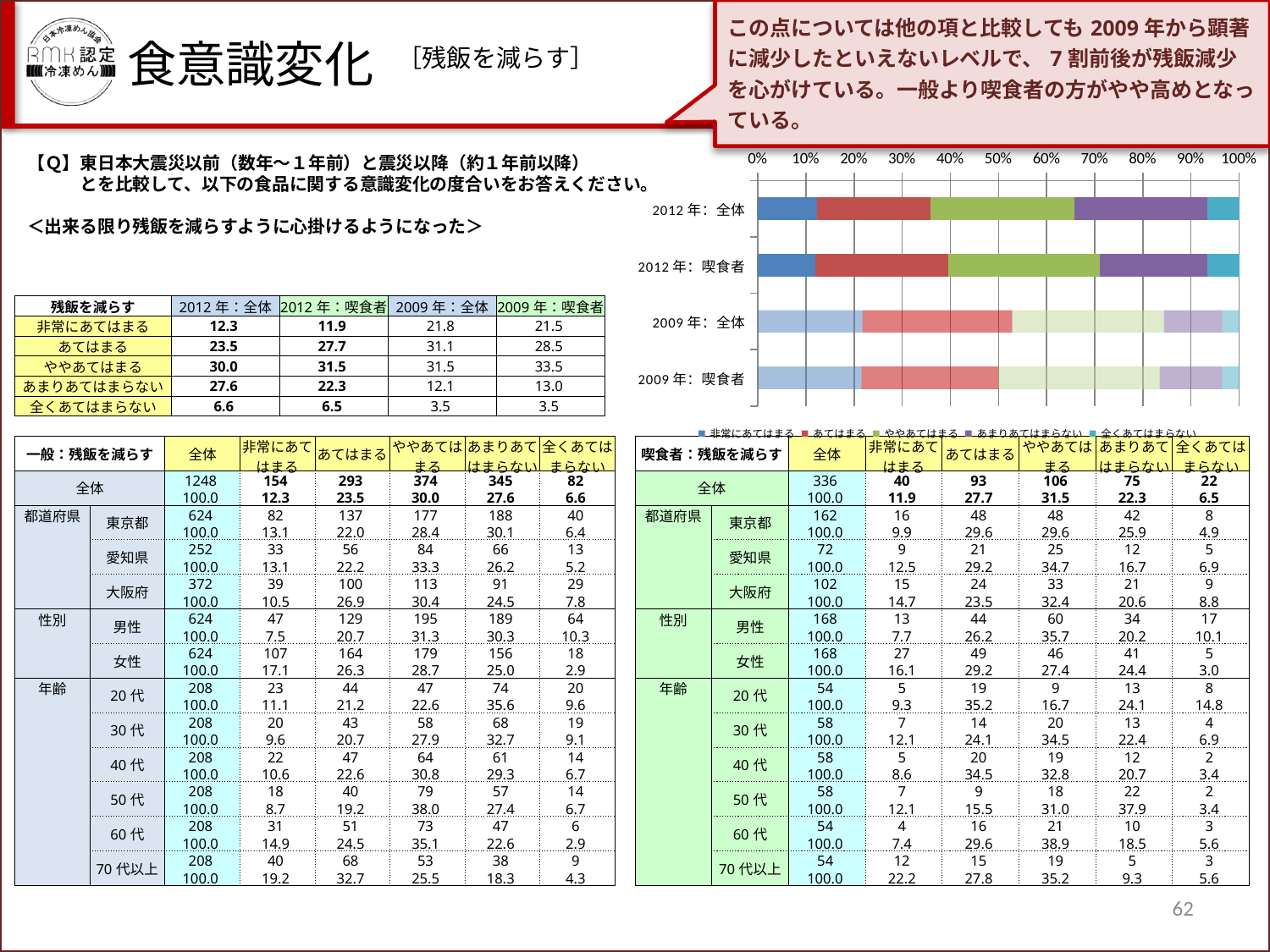
What is the value of ややあてはまる for 2009年：喫食者? 33.5 How many series does the chart's legend list? 5 What is the value of 非常にあてはまる for 2012年：全体? 12.3 Is the 非常にあてはまる segment for 2012年：全体 greater or less than 20%? less How many categories (bars) does the chart show? 4 Which category has the smallest あてはまる segment? 2012年：全体 What kind of chart is shown on the slide? bar chart What is the difference between the あまりあてはまらない values for 2012年：全体 and 2009年：全体? 15.5 What is the total of the stacked bar for 2012年：全体? 100.0 Which is larger, the あてはまる value for 2012年：全体 or for 2012年：喫食者? 2012年：喫食者 What is the highest value shown on the chart's percentage axis? 100% Which category has the largest あまりあてはまらない segment? 2012年：全体